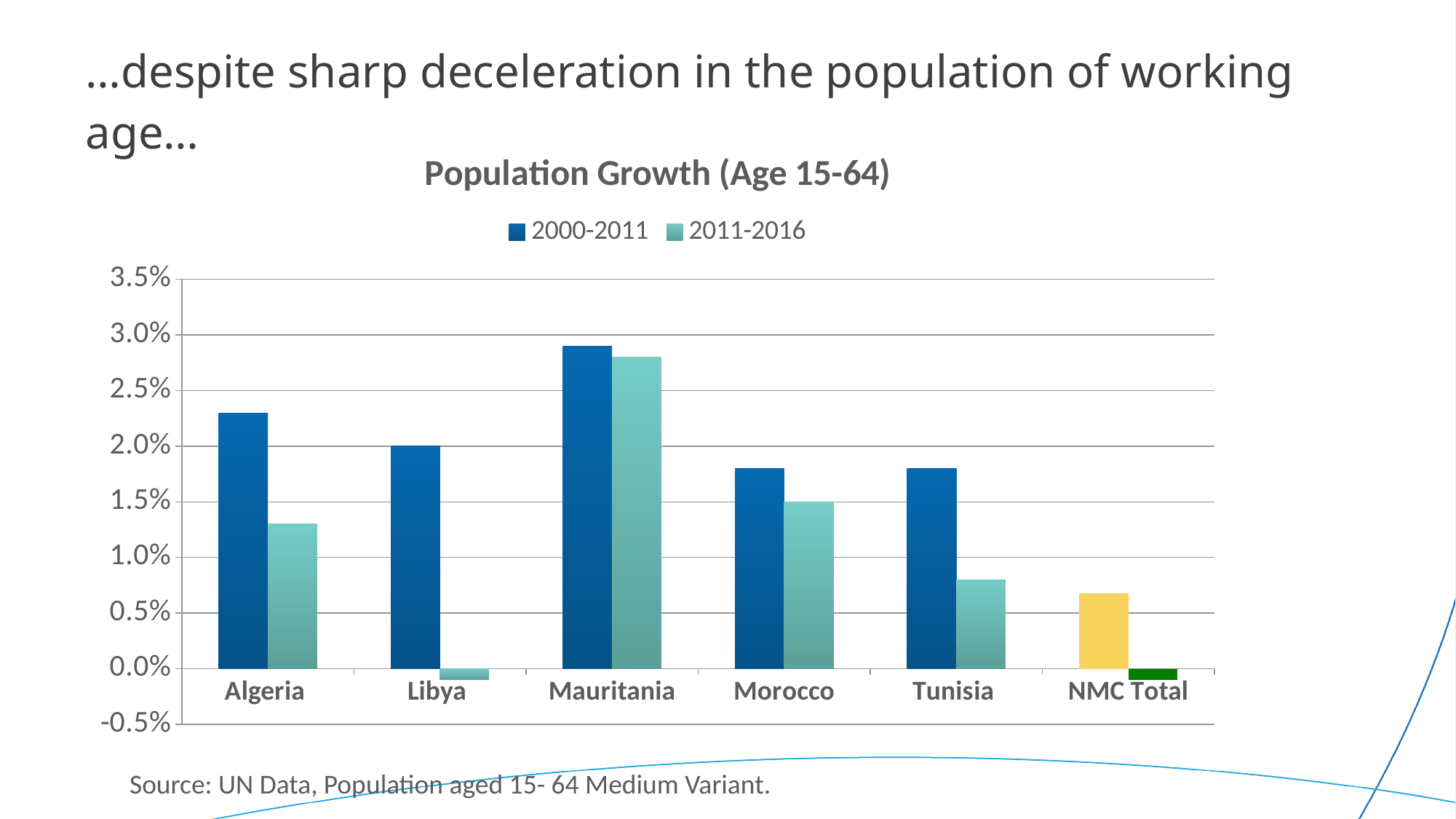
Which category has the lowest value for the 2000-2011 series? NMC Total Is the 2011-2016 value for Algeria greater or less than 1.0%? greater Which category has the highest value for the 2000-2011 series? Mauritania Is the 2011-2016 value for Libya greater or less than 0.0%? less What kind of chart is shown on the slide? bar chart Is the 2000-2011 value for Mauritania greater or less than 2.5%? greater How many series does the legend list? 2 What is the 2000-2011 value for Libya? 2.0% For Algeria, which is larger: the 2000-2011 value or the 2011-2016 value? 2000-2011 How many categories are shown on the x axis? 6 What is the title of the chart? Population Growth (Age 15-64)